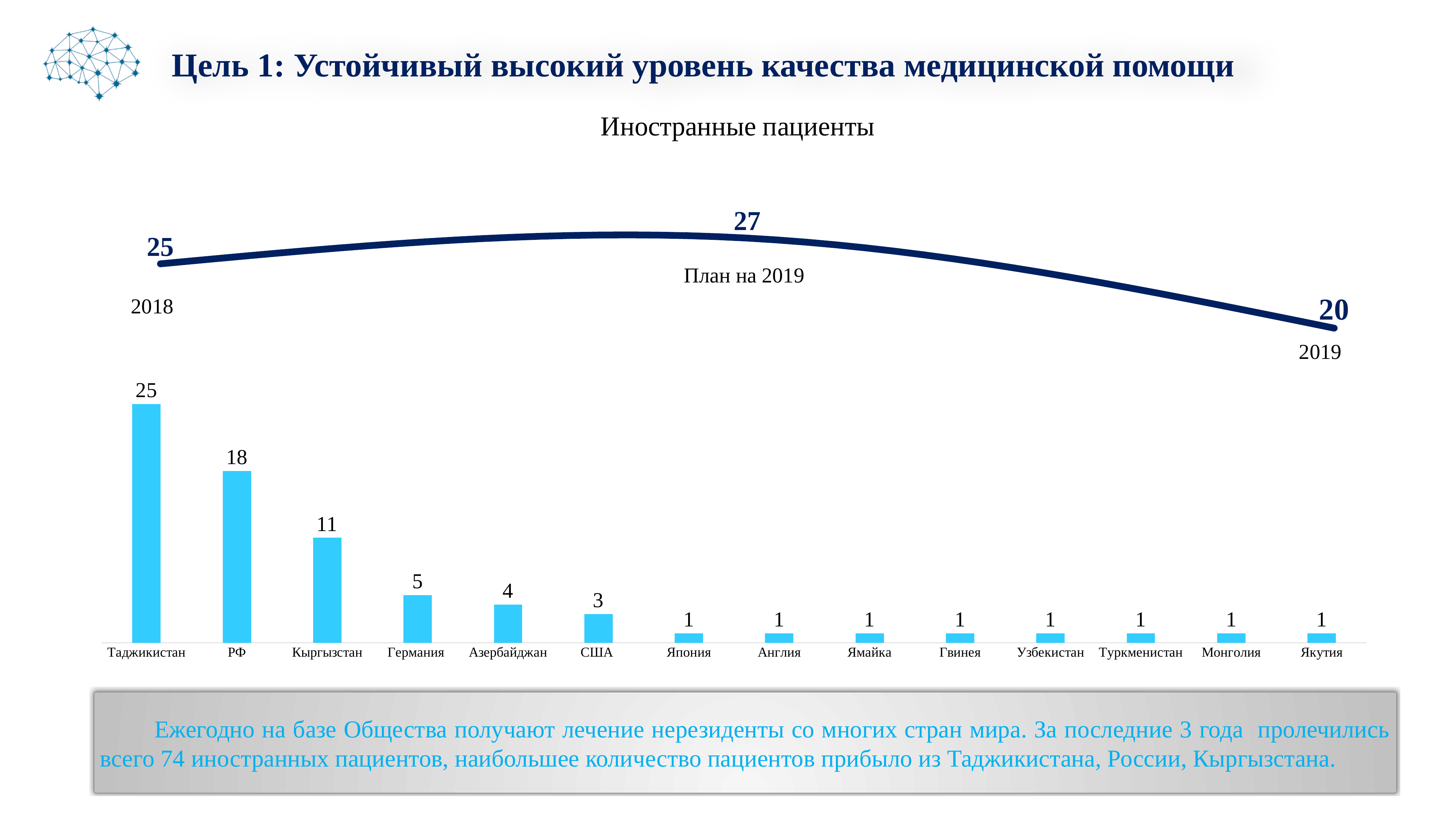
In the bar chart at the bottom of the slide, what is the value for Германия? 5 What kind of chart is the chart at the bottom of the slide? bar chart In the bar chart at the bottom of the slide, what is the value for РФ? 18 In the bar chart at the bottom of the slide, which category has the highest value? Таджикистан How many categories are shown in the bar chart at the bottom of the slide? 14 In the line chart at the top of the slide, what is the value labelled План на 2019? 27 What is the title shown above the charts on the slide? Иностранные пациенты In the bar chart at the bottom of the slide, what is the difference between the values for Таджикистан and Кыргызстан? 14 In the bar chart at the bottom of the slide, what is the value for Таджикистан? 25 In the line chart at the top of the slide, what is the difference between the value for План на 2019 and the value for 2019? 7 In the bar chart at the bottom of the slide, which is larger, the value for Азербайджан or the value for США? Азербайджан In the line chart at the top of the slide, what is the value for 2018? 25